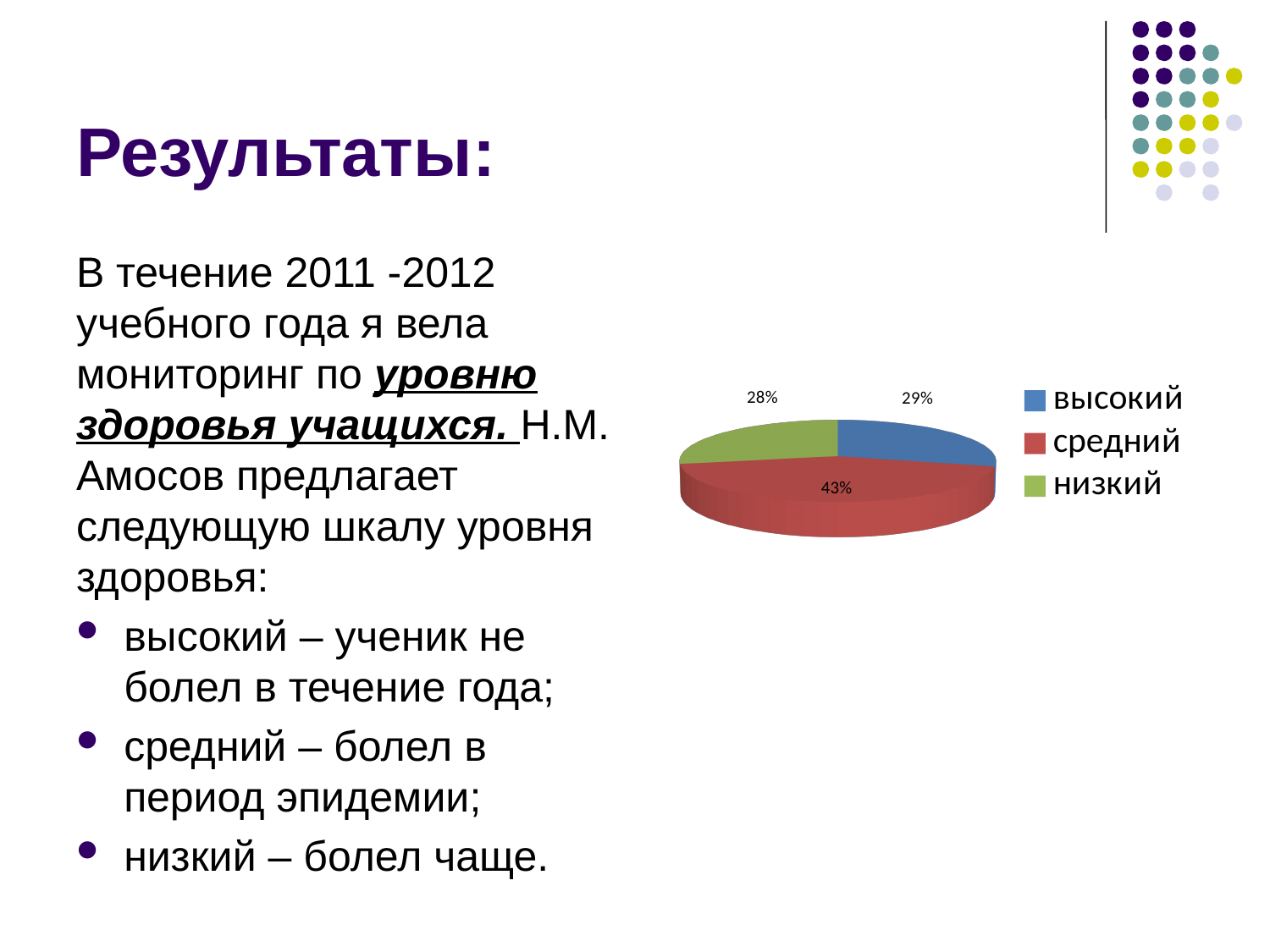
Which category has the largest slice of the pie? средний What colour is the "высокий" slice in the pie chart? blue How many entries does the legend list? 3 How many slices does the pie chart have? 3 Which category has the smallest slice of the pie? низкий What kind of chart is shown on the slide? pie chart What is the difference in percentage points between the "средний" and "высокий" slices? 14 What colour is the "низкий" slice in the pie chart? green What share of the pie does the "высокий" slice have? 29% Which is larger, the "средний" slice or the "низкий" slice? средний What share of the pie does the "низкий" slice have? 28% What share of the pie does the "средний" slice have? 43%